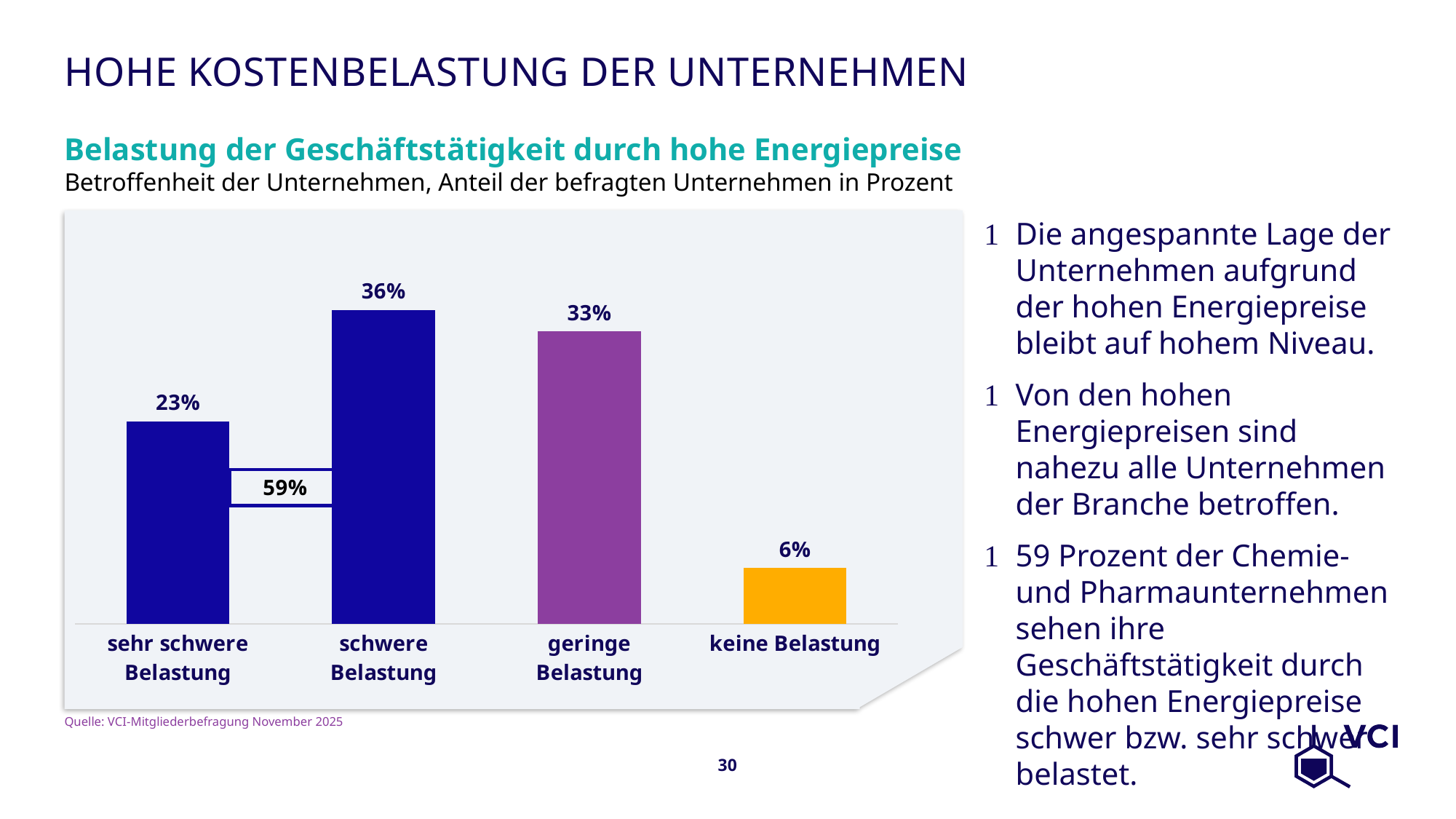
Which category has the highest value? schwere Belastung Which category has the lowest value? keine Belastung What is the value for "geringe Belastung"? 33% What is the title of the chart? Belastung der Geschäftstätigkeit durch hohe Energiepreise What kind of chart is shown on the slide? bar chart What is the value for "sehr schwere Belastung"? 23% How many categories are shown in the chart? 4 What is the value for "keine Belastung"? 6% What combined value is shown in the bracket linking "sehr schwere Belastung" and "schwere Belastung"? 59% Which is larger, the value for "geringe Belastung" or the value for "keine Belastung"? geringe Belastung What is the value for "schwere Belastung"? 36% What is the difference between the values for "schwere Belastung" and "sehr schwere Belastung"? 13%